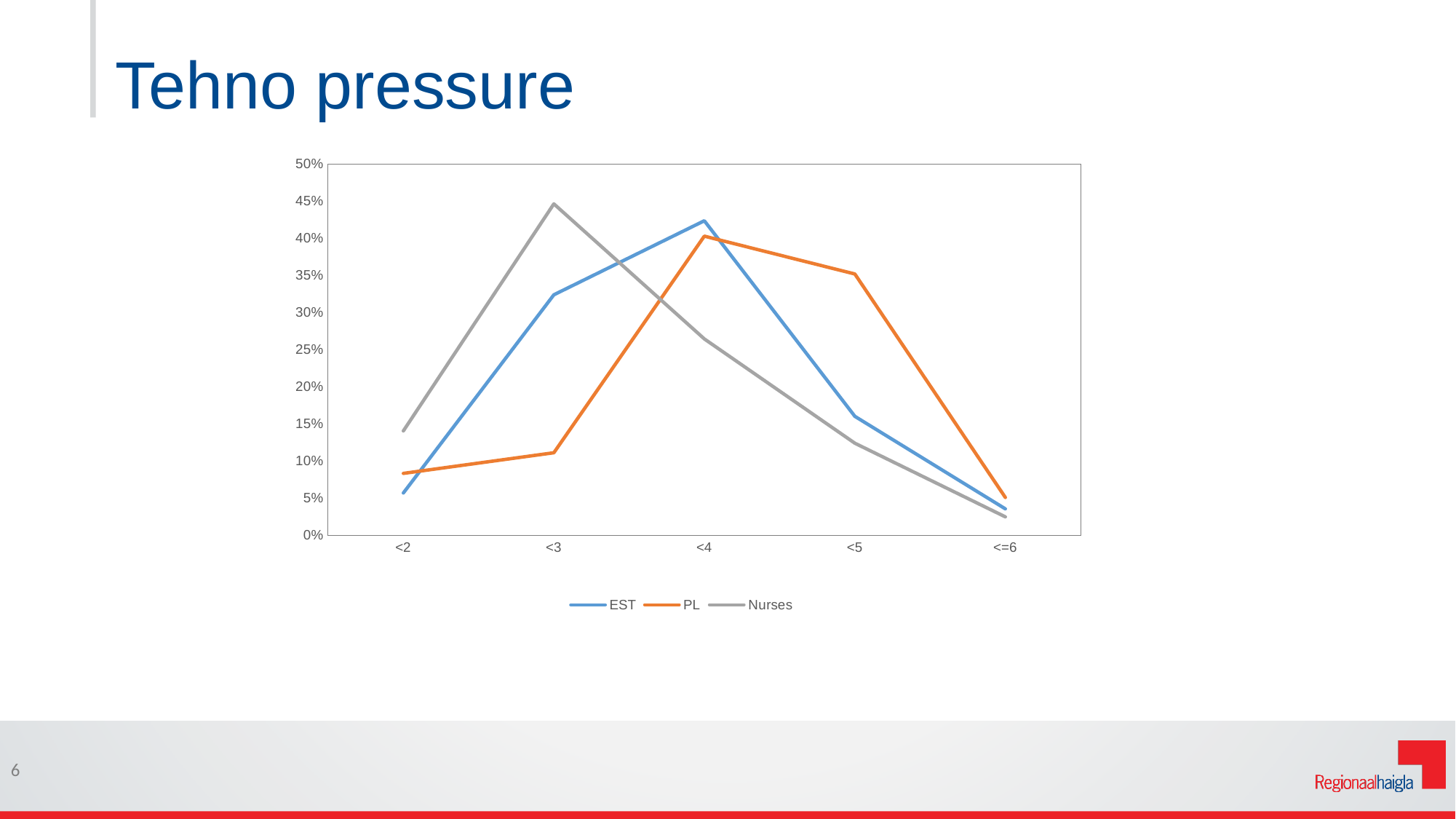
At <5, which series has the larger value, PL or EST? PL How many series does the legend list? 3 What kind of chart is shown on the slide? line chart Which series are listed in the legend? EST, PL, Nurses At which category does the Nurses series reach its lowest value? <=6 At which category does the PL series reach its highest value? <4 What is the title of the slide containing the chart? Tehno pressure Is the value for EST at <4 greater or less than 40%? greater Is the value for Nurses at <2 greater or less than 10%? greater At which category does the Nurses series reach its highest value? <3 How many categories are shown on the x axis? 5 At which category does the EST series reach its highest value? <4